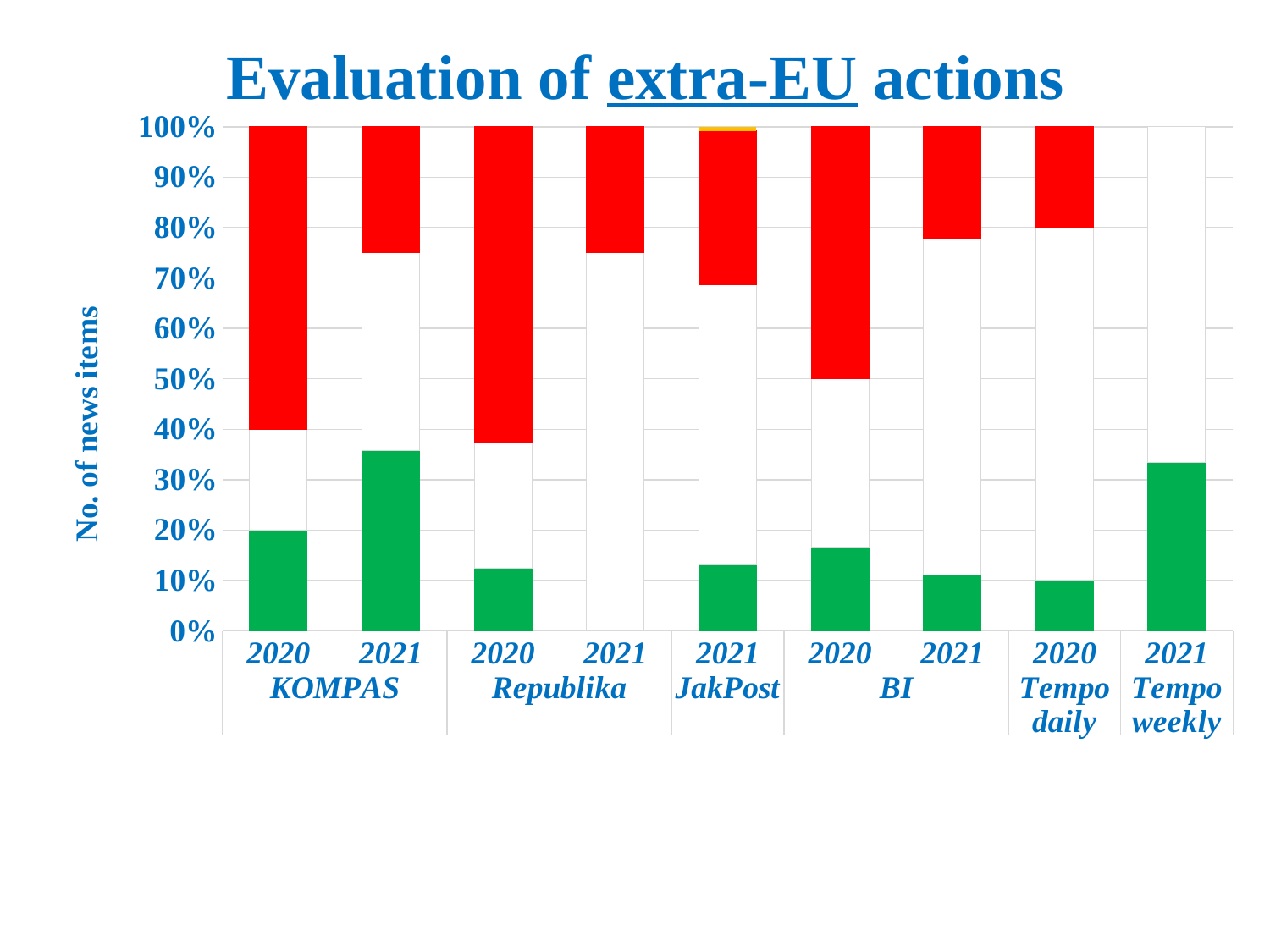
How many bars are plotted in the chart? 9 Which is larger, the green segment for KOMPAS 2020 or the green segment for KOMPAS 2021? KOMPAS 2021 Is the green segment for KOMPAS 2021 greater or less than 30%? greater What is the label on the vertical axis of the chart? No. of news items Is the green segment for Republika 2020 greater or less than 20%? less Is the green segment for BI 2021 greater or less than 20%? less What is the title of the chart? Evaluation of extra-EU actions What kind of chart is shown on the slide? Stacked bar chart Which is larger, the red segment for BI 2020 or the red segment for BI 2021? BI 2020 Which bar has no red segment at all? Tempo weekly 2021 Which bar has no green segment at all? Republika 2021